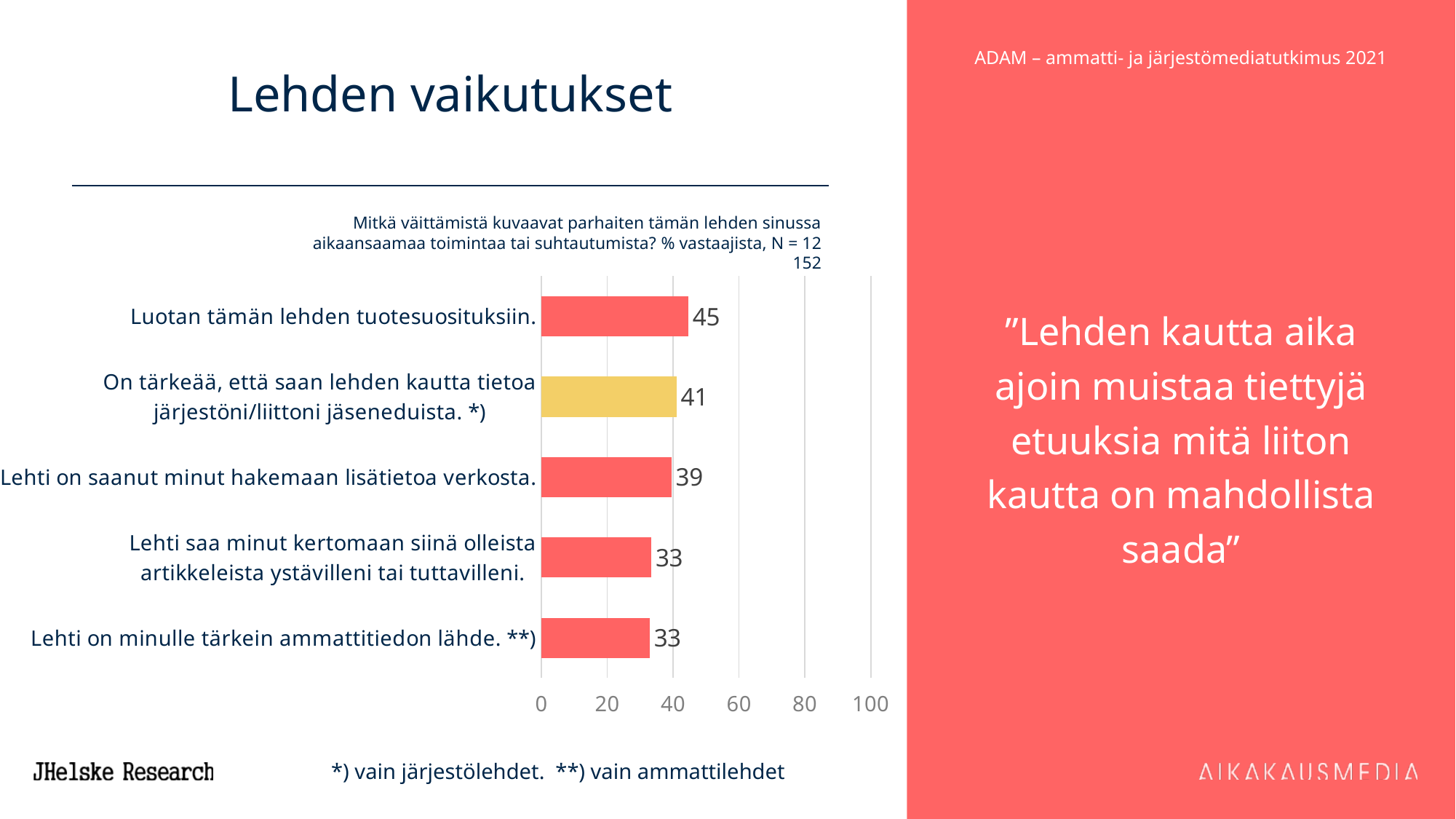
What is the value for "On tärkeää, että saan lehden kautta tietoa järjestöni/liittoni jäseneduista. *)"? 41 What is the value for "Luotan tämän lehden tuotesuosituksiin."? 45 What is the value for "Lehti on saanut minut hakemaan lisätietoa verkosta."? 39 How many categories are shown in the chart? 5 Which category has the highest value? Luotan tämän lehden tuotesuosituksiin. What is the value for "Lehti saa minut kertomaan siinä olleista artikkeleista ystävilleni tai tuttavilleni."? 33 Which is larger: the value for "On tärkeää, että saan lehden kautta tietoa järjestöni/liittoni jäseneduista. *)" or the value for "Lehti on saanut minut hakemaan lisätietoa verkosta."? On tärkeää, että saan lehden kautta tietoa järjestöni/liittoni jäseneduista. *) What is the difference between the values for "Luotan tämän lehden tuotesuosituksiin." and "Lehti on minulle tärkein ammattitiedon lähde. **)"? 12 What kind of chart is shown on the slide? bar chart Is the value for "Lehti saa minut kertomaan siinä olleista artikkeleista ystävilleni tai tuttavilleni." greater or less than 40? less Which bar is coloured differently (yellow) from the others? On tärkeää, että saan lehden kautta tietoa järjestöni/liittoni jäseneduista. *) What is the maximum value shown on the x axis? 100